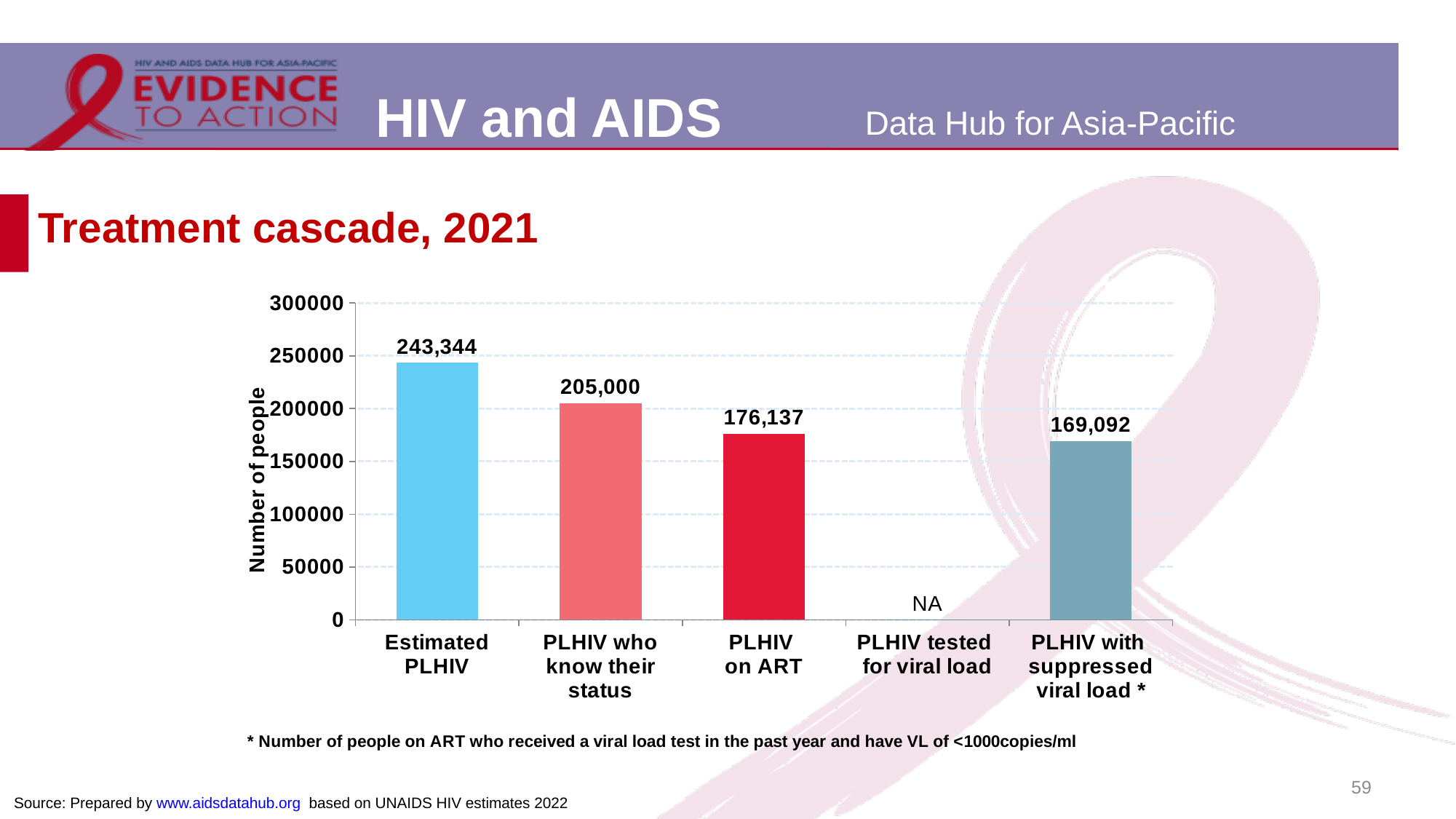
What kind of chart is this? Bar chart Which is larger, PLHIV who know their status or PLHIV on ART? PLHIV who know their status What is shown for PLHIV tested for viral load? NA What is the difference between Estimated PLHIV and PLHIV on ART? 67,207 Which category with a plotted bar has the lowest value? PLHIV with suppressed viral load Which category has the highest value? Estimated PLHIV What is the value for Estimated PLHIV? 243,344 What is the value for PLHIV with suppressed viral load? 169,092 How many categories are shown on the x axis? 5 What is the value for PLHIV who know their status? 205,000 What is the y-axis label of the chart? Number of people What is the value for PLHIV on ART? 176,137